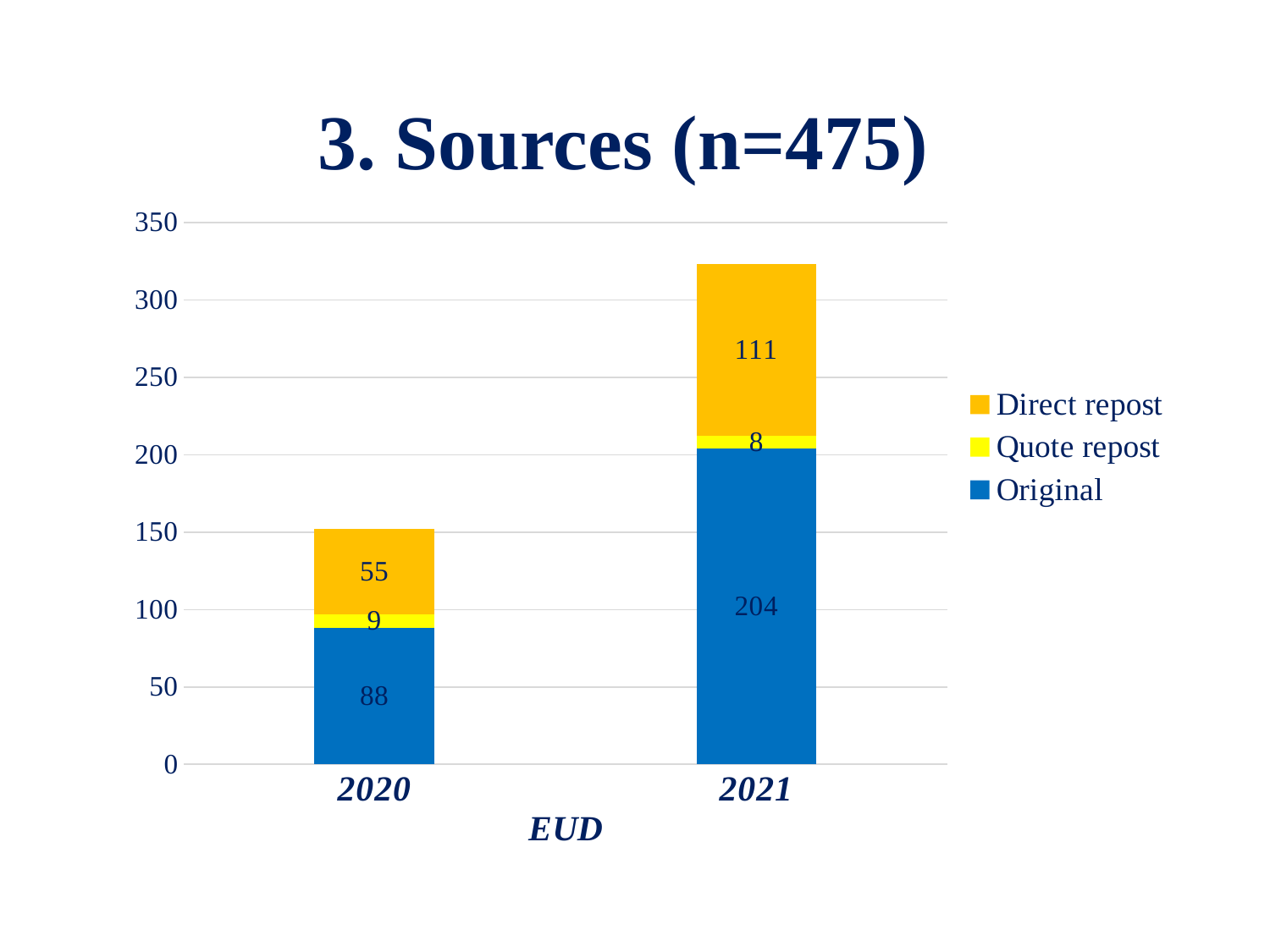
What is the value for Original in 2020? 88 What is the value for Quote repost in 2021? 8 Which year has the larger Direct repost value, 2020 or 2021? 2021 What kind of chart is shown on the slide? Stacked bar chart How many series does the legend list? 3 What is the difference between the Original values for 2021 and 2020? 116 What is the title of the chart? 3. Sources (n=475) How many categories are shown on the x axis? 2 What is the total of the stacked bar for 2020? 152 What is the value for Quote repost in 2020? 9 What is the value for Direct repost in 2021? 111 What is the total of the stacked bar for 2021? 323